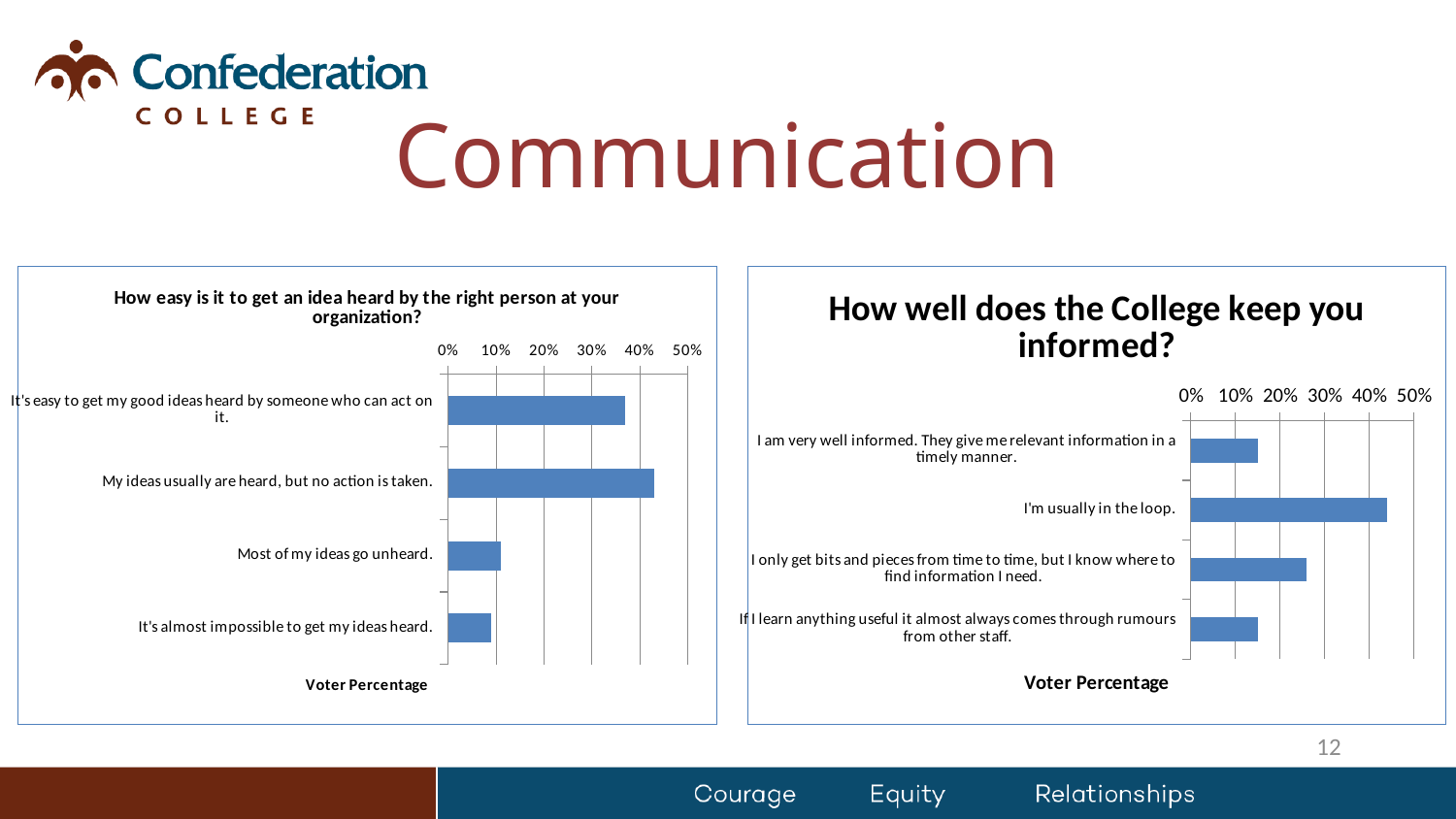
In the chart titled "How well does the College keep you informed?", is the value for "I am very well informed. They give me relevant information in a timely manner." greater or less than 20%? less How many categories are shown in the chart titled "How well does the College keep you informed?"? 4 In the chart titled "How easy is it to get an idea heard by the right person at your organization?", is the value for "Most of my ideas go unheard." greater or less than 20%? less In the chart titled "How easy is it to get an idea heard by the right person at your organization?", which category has the highest value? My ideas usually are heard, but no action is taken. In the chart titled "How easy is it to get an idea heard by the right person at your organization?", is the value for "It's easy to get my good ideas heard by someone who can act on it." greater or less than 30%? greater How many categories are shown in the chart titled "How easy is it to get an idea heard by the right person at your organization?"? 4 What type of chart is the chart titled "How easy is it to get an idea heard by the right person at your organization?"? Bar chart In the chart titled "How easy is it to get an idea heard by the right person at your organization?", which is larger: "My ideas usually are heard, but no action is taken." or "It's almost impossible to get my ideas heard."? My ideas usually are heard, but no action is taken. In the chart titled "How well does the College keep you informed?", which is larger: "I only get bits and pieces from time to time, but I know where to find information I need." or "If I learn anything useful it almost always comes through rumours from other staff."? I only get bits and pieces from time to time, but I know where to find information I need. What is the x-axis title of the chart titled "How well does the College keep you informed?"? Voter Percentage In the chart titled "How well does the College keep you informed?", which category has the highest value? I'm usually in the loop.